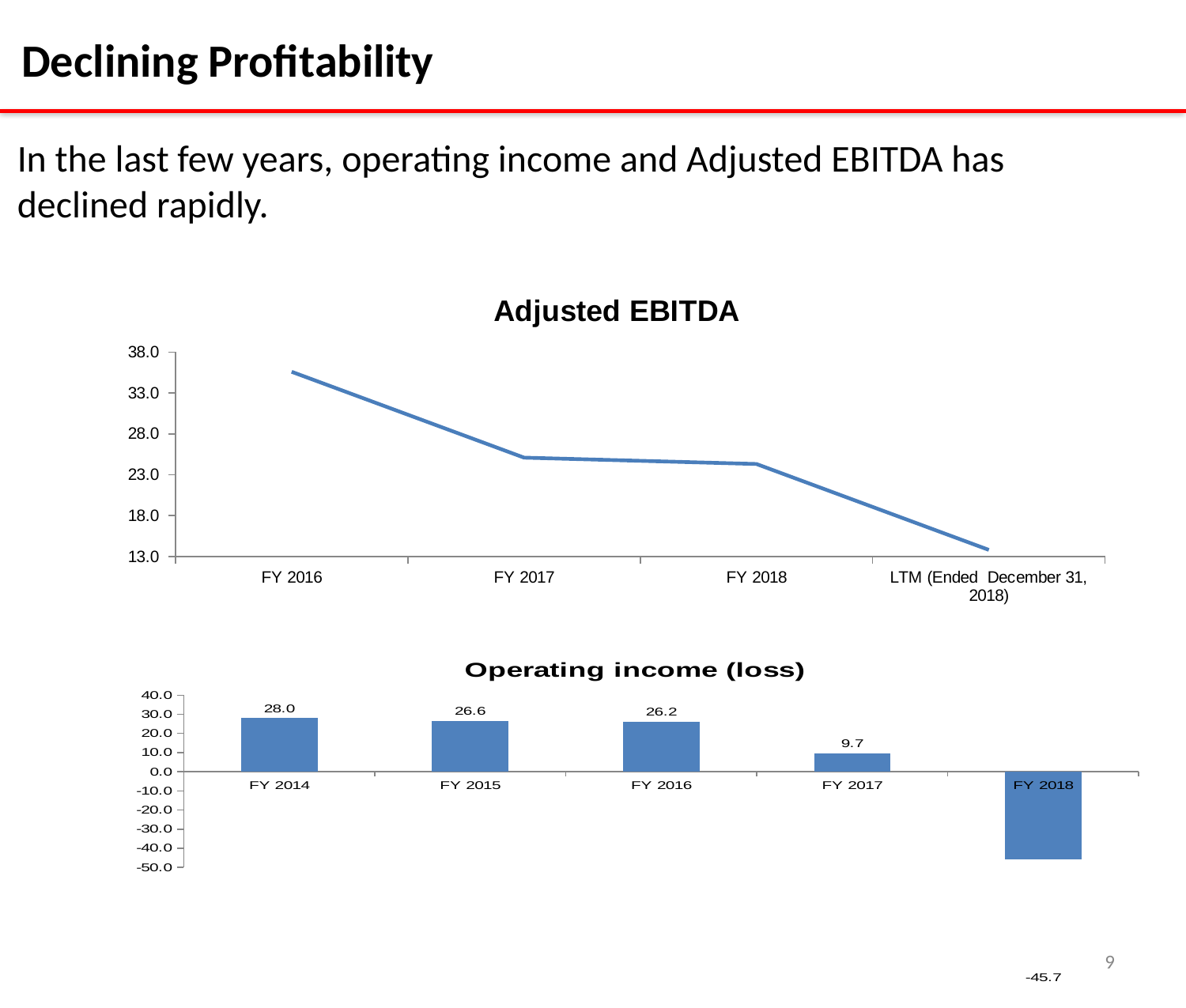
On the Operating income (loss) chart, what is the value for FY 2017? 9.7 On the Operating income (loss) chart, what is the difference between the FY 2014 and FY 2015 values? 1.4 What kind of chart is the Operating income (loss) chart? bar chart On the Adjusted EBITDA chart, is the value for FY 2016 greater or less than 33.0? greater How many bars are shown on the Operating income (loss) chart? 5 On the Operating income (loss) chart, what is the difference between the FY 2016 and FY 2017 values? 16.5 On the Operating income (loss) chart, what is the value for FY 2014? 28.0 On the Adjusted EBITDA chart, do the values rise or fall from FY 2016 to LTM (Ended December 31, 2018)? fall What kind of chart is the Adjusted EBITDA chart? line chart How many data points are plotted on the Adjusted EBITDA chart? 4 On the Operating income (loss) chart, which year has the lowest value? FY 2018 On the Operating income (loss) chart, which year has the highest value? FY 2014